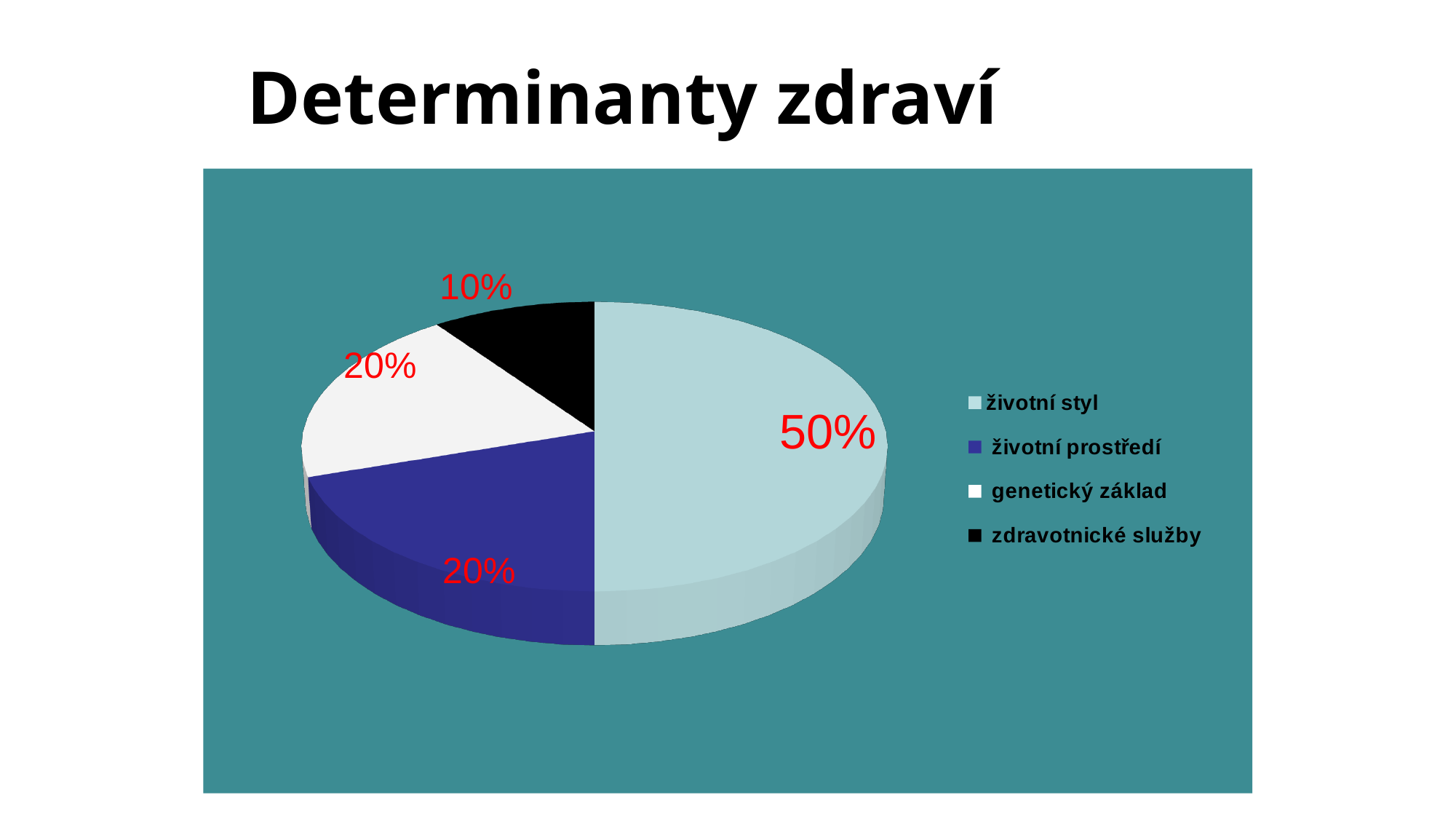
What share of the pie does životní prostředí have? 20% Which category has the smallest slice of the pie? zdravotnické služby What colour is the slice for zdravotnické služby? black What share of the pie does zdravotnické služby have? 10% What is the difference in percentage points between životní styl and zdravotnické služby? 40 What share of the pie does životní styl have? 50% Which is larger, the slice for životní styl or the slice for genetický základ? životní styl What share of the pie does genetický základ have? 20% Which category has the largest slice of the pie? životní styl What kind of chart is shown on the slide? pie chart How many categories does the pie chart have? 4 What is the title of the slide? Determinanty zdraví